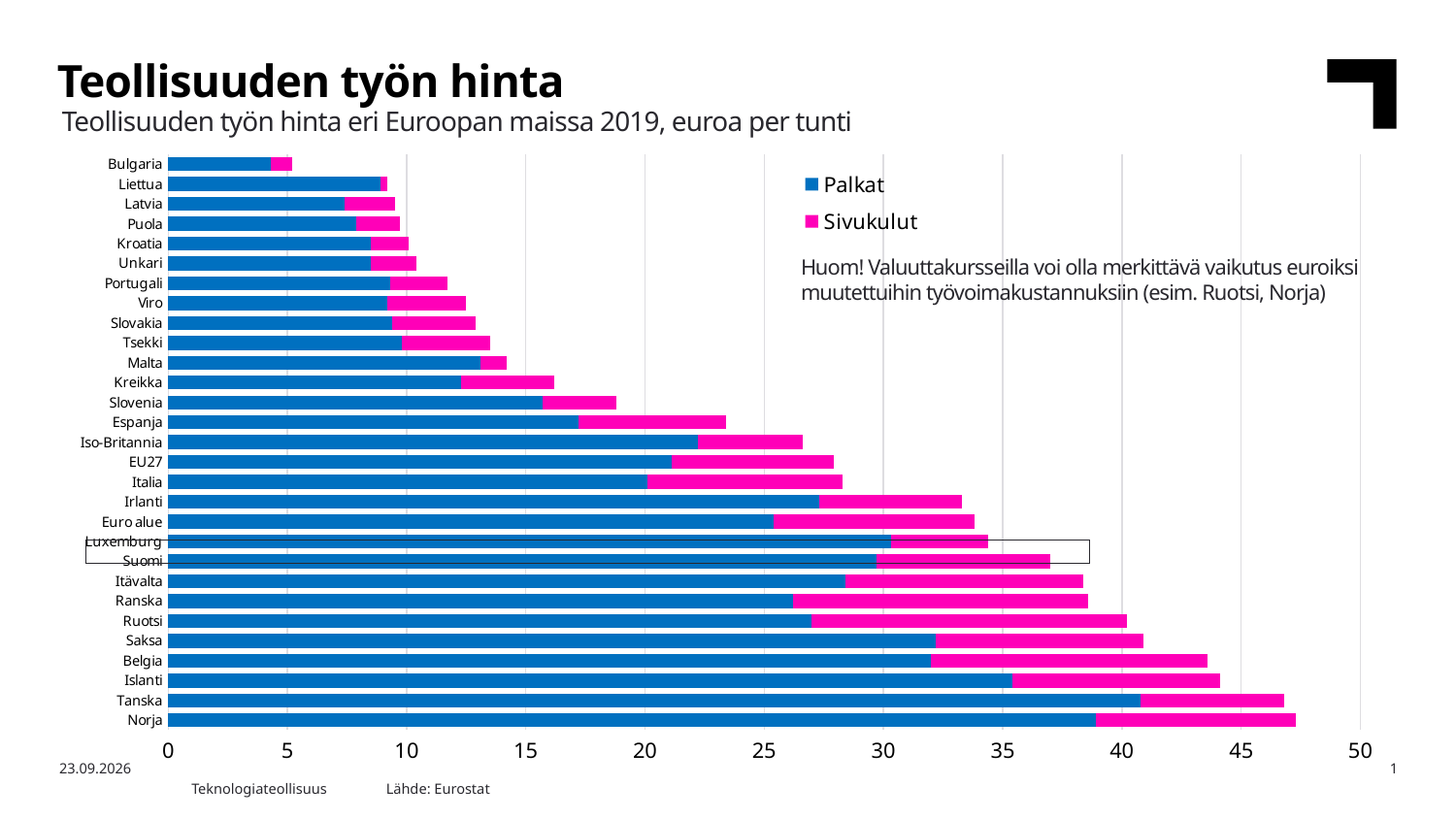
Is the total value for Espanja greater or less than 20? greater Is the total value for Belgia greater or less than 40? greater How many series does the legend list? 2 How many countries or regions are shown on the chart? 29 Which series is shown in pink/magenta in the legend? Sivukulut What is the title of the chart? Teollisuuden työn hinta What kind of chart is shown on the slide? bar chart Is the total value for Bulgaria greater or less than 10? less Which has the larger total value, Tanska or Saksa? Tanska Which country has the lowest total labour cost on the chart? Bulgaria